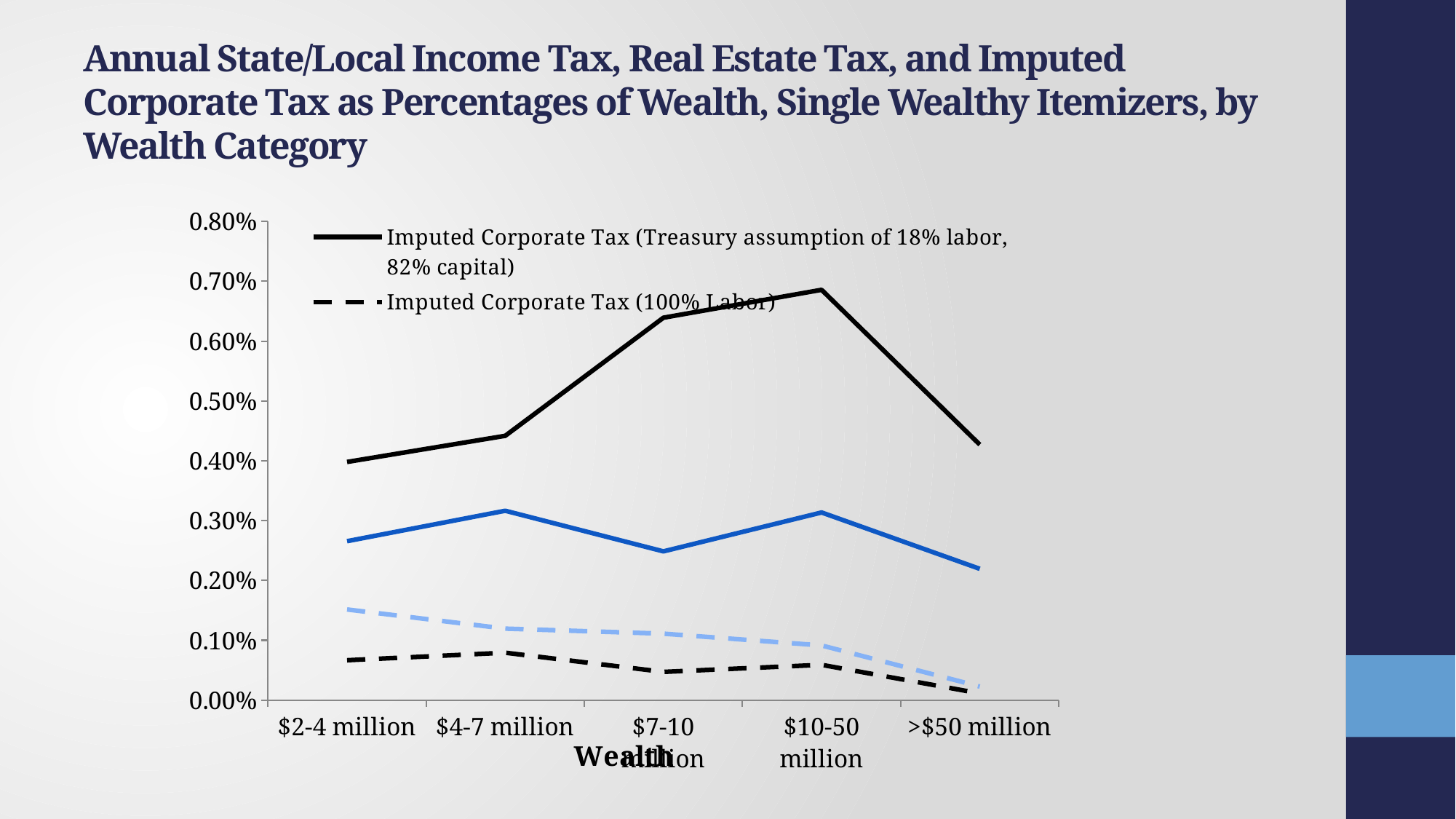
Is the value of the Imputed Corporate Tax (Treasury assumption of 18% labor, 82% capital) line for >$50 million greater or less than 0.50%? less How many series does the legend list? 2 Is the value of the Imputed Corporate Tax (100% Labor) line for $2-4 million greater or less than 0.10%? less Which is larger for the Imputed Corporate Tax (Treasury assumption of 18% labor, 82% capital) line: the value for $4-7 million or the value for $10-50 million? $10-50 million Is the value of the Imputed Corporate Tax (Treasury assumption of 18% labor, 82% capital) line for $10-50 million greater or less than 0.60%? greater What is the title of the x axis? Wealth Which legend entry is drawn with a dashed line? Imputed Corporate Tax (100% Labor) For which wealth category is the Imputed Corporate Tax (100% Labor) line lowest? >$50 million Does the dashed light blue line rise or fall as wealth increases from $2-4 million to >$50 million? fall For which wealth category is the Imputed Corporate Tax (Treasury assumption of 18% labor, 82% capital) line highest? $10-50 million How many wealth categories are shown on the x axis? 5 What kind of chart is shown on the slide? line chart